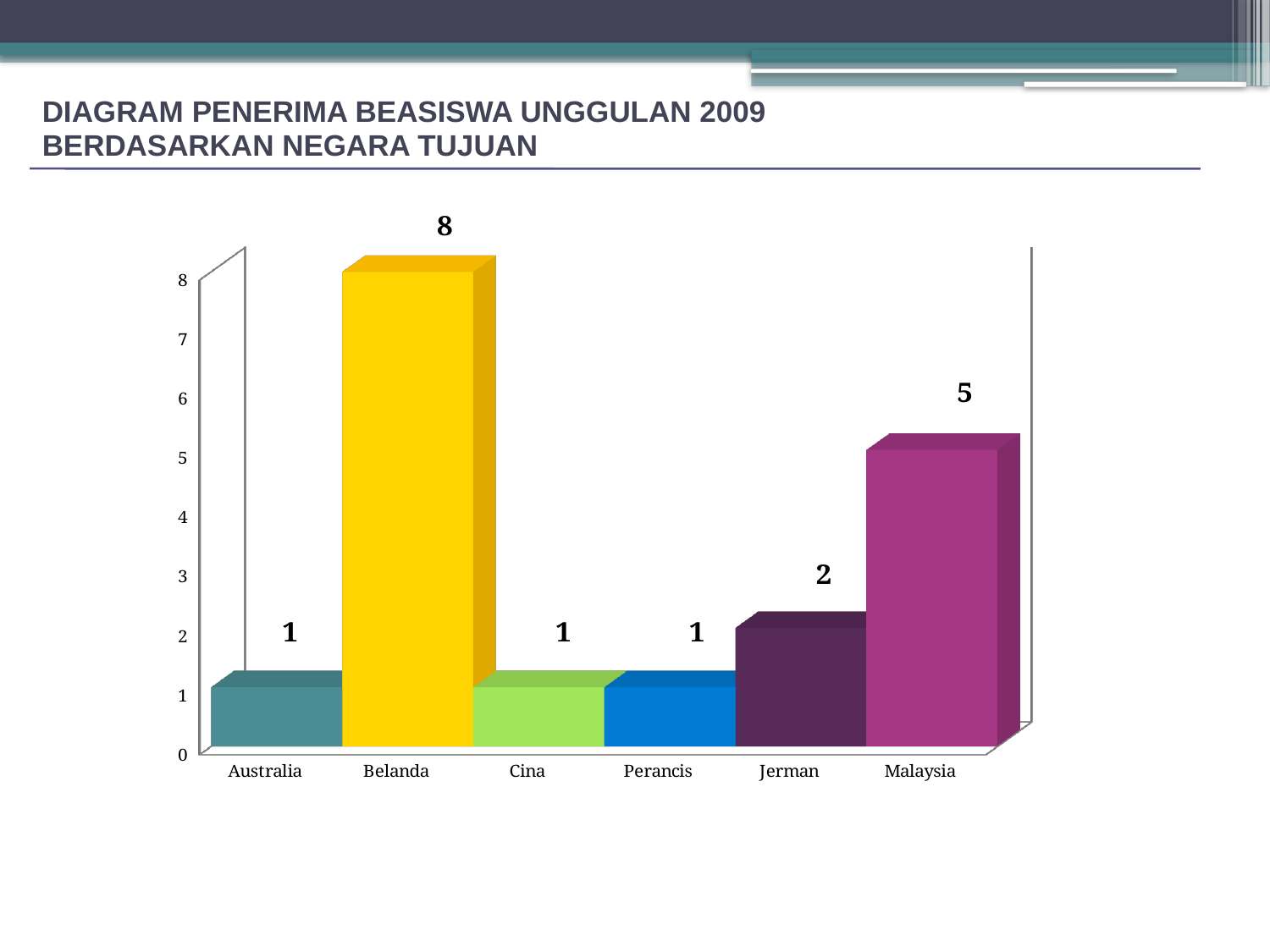
Which country has the highest value? Belanda What is the value for Jerman? 2 What is the value for Belanda? 8 What is the value for Malaysia? 5 What is the difference between the values for Malaysia and Jerman? 3 What is the value for Australia? 1 What kind of chart is shown on the slide? Bar chart How many countries are shown on the x axis? 6 What is the difference between the values for Belanda and Malaysia? 3 Which is larger, the value for Jerman or the value for Cina? Jerman Which is larger, the value for Malaysia or the value for Belanda? Belanda What is the title of the slide? DIAGRAM PENERIMA BEASISWA UNGGULAN 2009 BERDASARKAN NEGARA TUJUAN